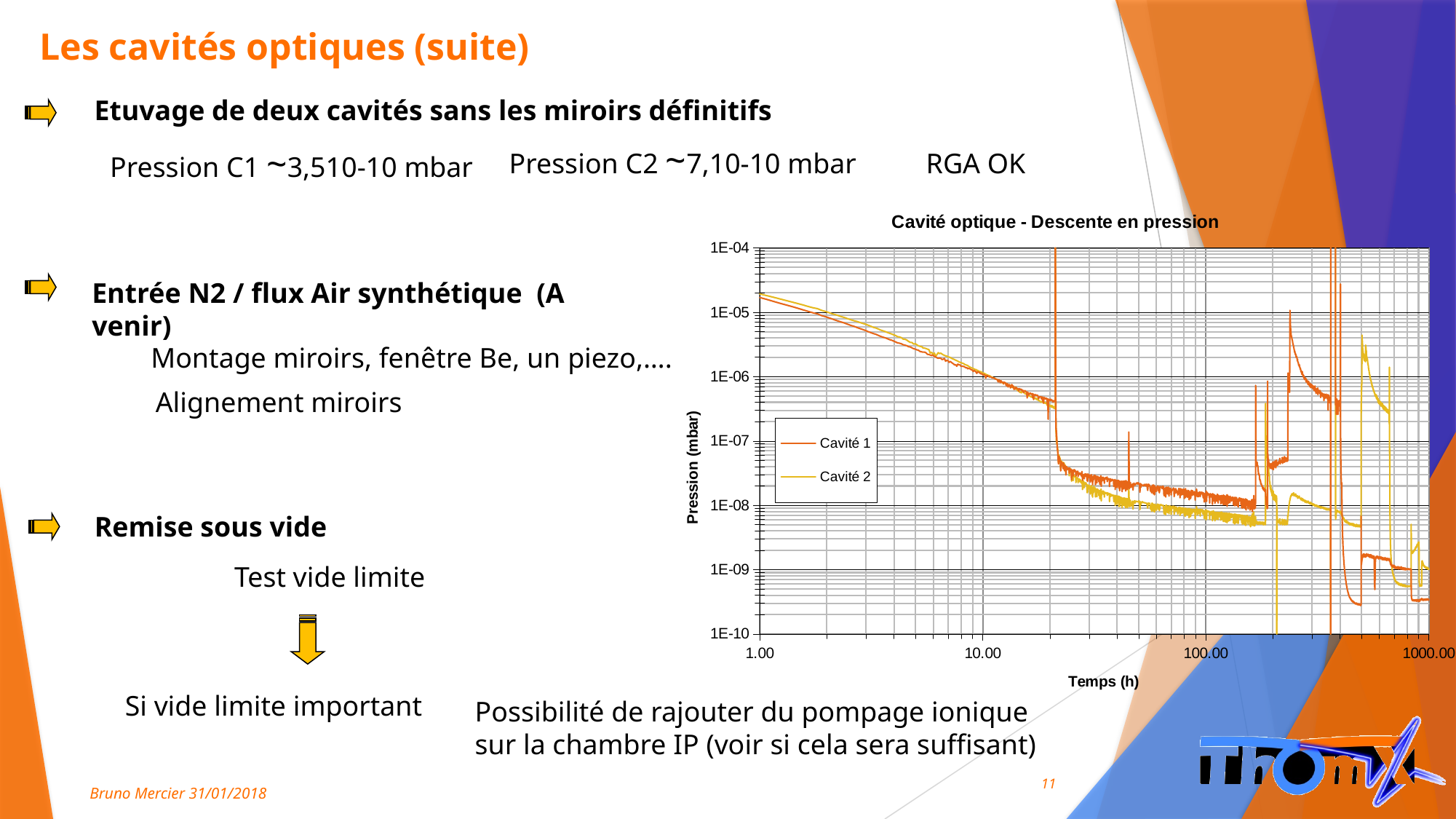
At 100.00 h, is the pressure of Cavité 1 greater or less than 1E-07 mbar? less What is the lowest value labelled on the y axis of the chart? 1E-10 What is the label of the y axis of the chart? Pression (mbar) At 1.00 h, is the pressure of Cavité 1 greater or less than 1E-04 mbar? less How many series does the legend of the chart list? 2 What is the title of the chart? Cavité optique - Descente en pression At 100.00 h, which series shows the higher pressure, Cavité 1 or Cavité 2? Cavité 1 Overall, does the pressure rise or fall as time increases along the x axis? Fall At 100.00 h, is the pressure of Cavité 2 greater or less than 1E-08 mbar? less What kind of chart is shown on the slide? Line chart What is the highest value labelled on the x axis of the chart? 1000.00